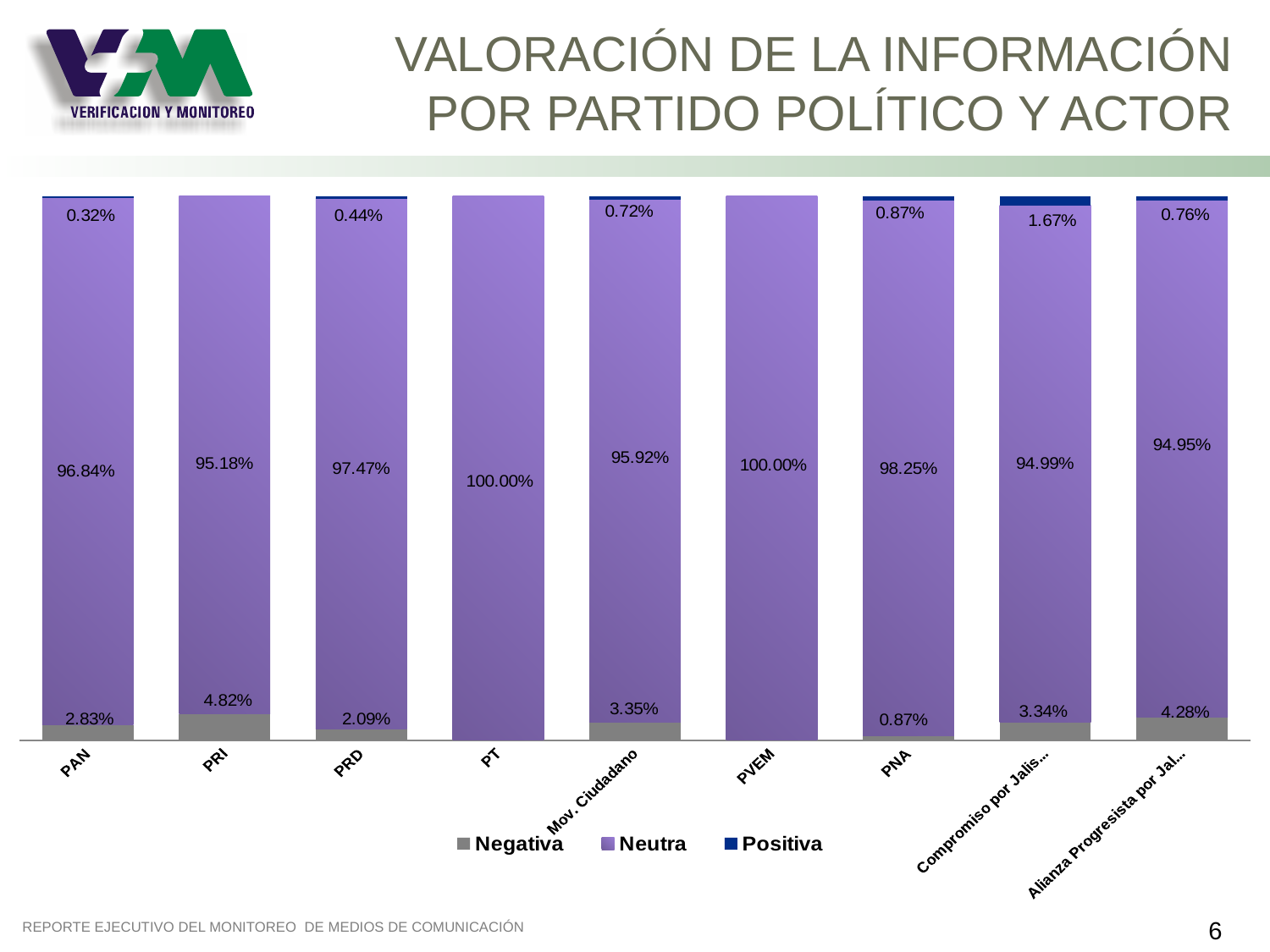
What is the difference between the Neutra value for PRD and the Neutra value for PAN? 0.63 percentage points What is the Neutra value for PT? 100.00% What is the Positiva value for Mov. Ciudadano? 0.72% What kind of chart is shown on the slide? Stacked bar chart What is the Negativa value for PNA? 0.87% What is the Neutra value for PAN? 96.84% What is the Negativa value for PRI? 4.82% How many parties are shown on the x axis? 9 Which has a larger Negativa value, PAN or PRD? PAN Which party has the highest Positiva value? Compromiso por Jalisco Which party has the highest Negativa value? PRI How many series does the legend list? 3